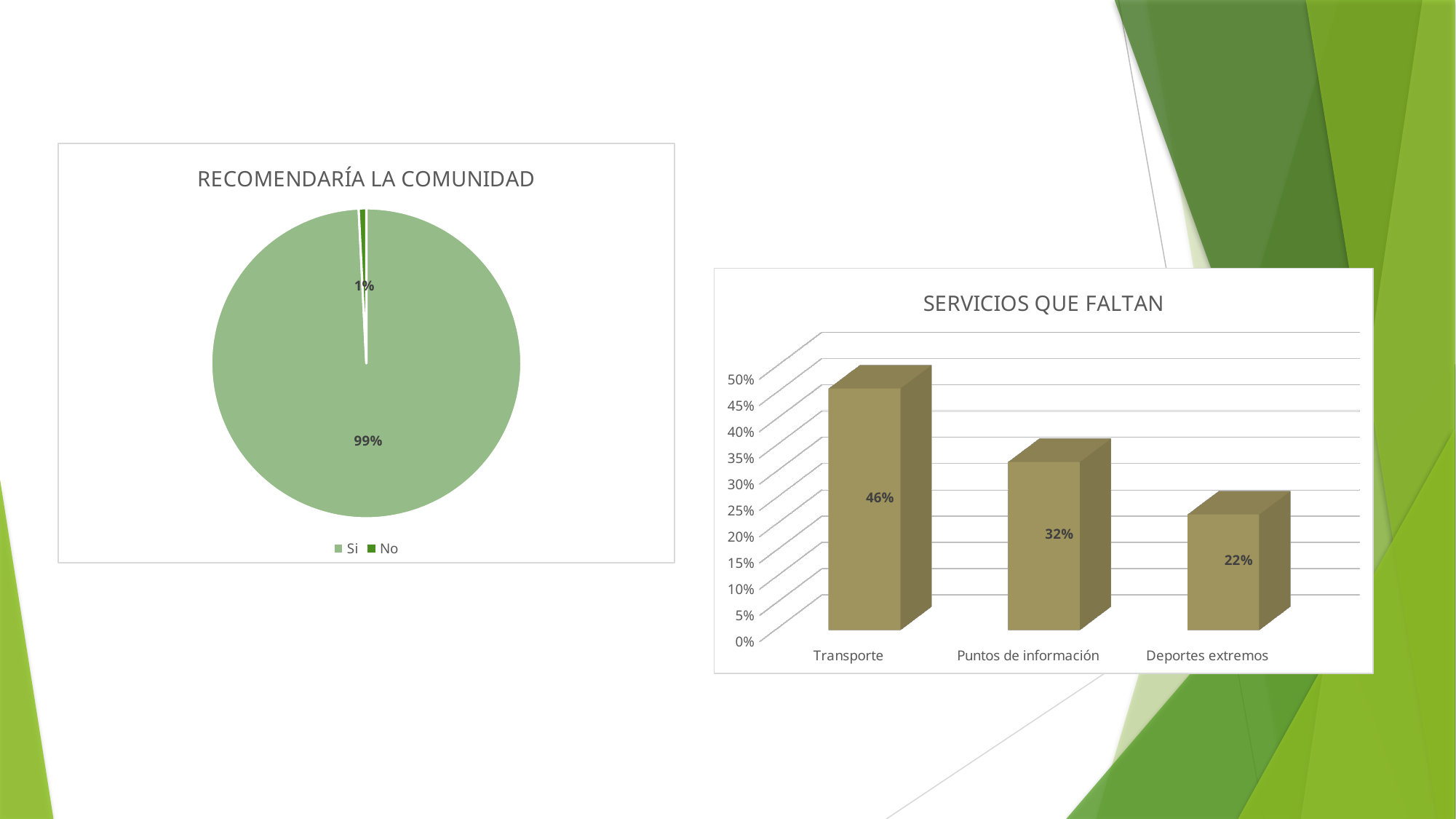
What kind of chart is 'SERVICIOS QUE FALTAN'? Bar chart In the 'SERVICIOS QUE FALTAN' chart, what is the difference between the values for 'Transporte' and 'Deportes extremos'? 24% What kind of chart is 'RECOMENDARÍA LA COMUNIDAD'? Pie chart In the 'RECOMENDARÍA LA COMUNIDAD' chart, what share of the pie is 'No'? 1% How many entries does the legend of the 'RECOMENDARÍA LA COMUNIDAD' chart list? 2 In the 'SERVICIOS QUE FALTAN' chart, which category has the lowest value? Deportes extremos In the 'SERVICIOS QUE FALTAN' chart, which category has the highest value? Transporte In the 'SERVICIOS QUE FALTAN' chart, what is the value for 'Puntos de información'? 32% In the 'RECOMENDARÍA LA COMUNIDAD' chart, which slice is larger, 'Si' or 'No'? Si In the 'RECOMENDARÍA LA COMUNIDAD' chart, what share of the pie is 'Si'? 99% In the 'SERVICIOS QUE FALTAN' chart, what is the value for 'Deportes extremos'? 22% In the 'SERVICIOS QUE FALTAN' chart, what is the value for 'Transporte'? 46%